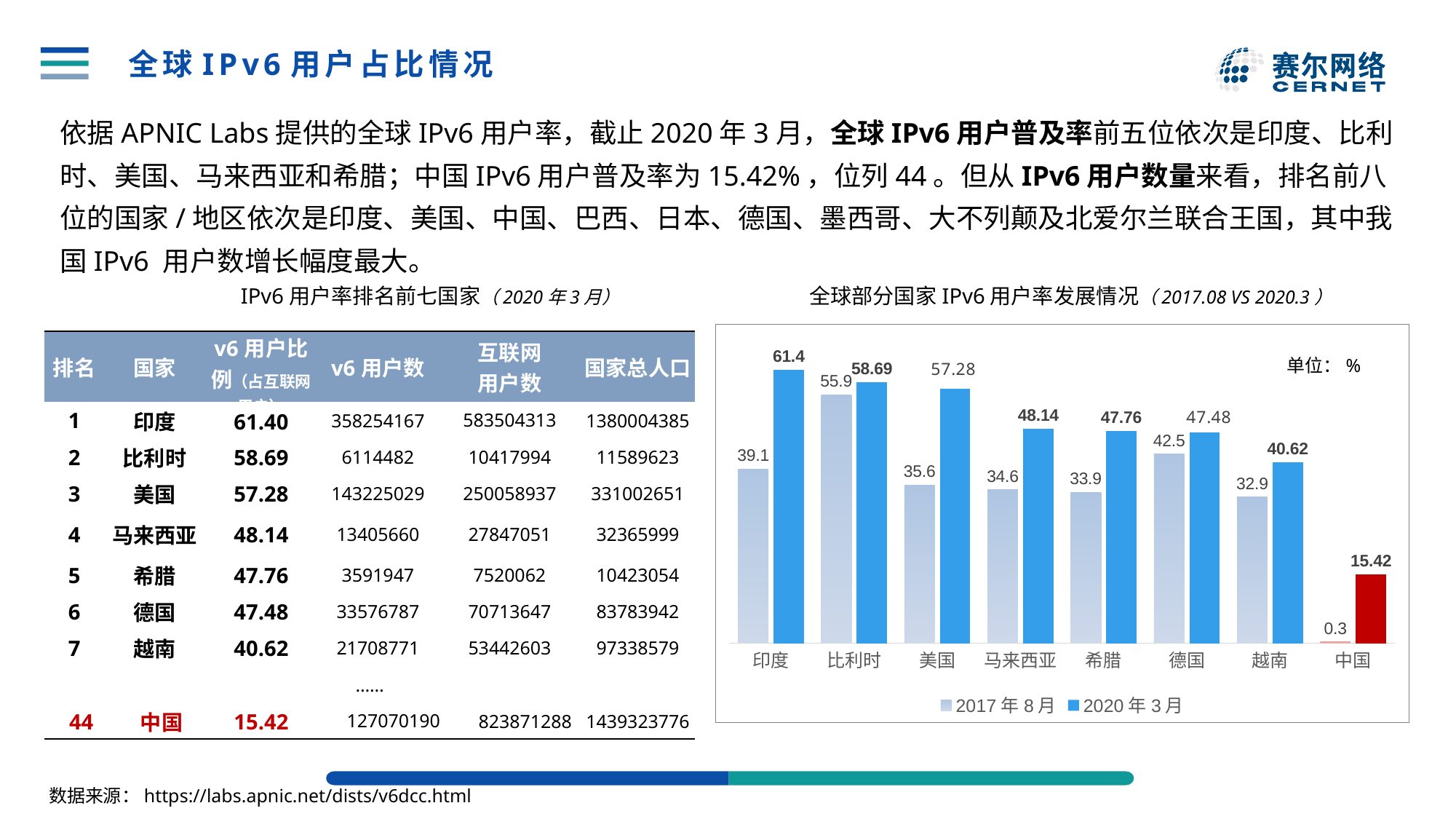
What kind of chart is shown on the right side of the slide? bar chart In the chart on the right, which country has the lowest value for 2017年8月? 中国 In the chart on the right, which is larger: the 2017年8月 value for 德国 or the 2017年8月 value for 印度? 德国 In the chart on the right, how many countries are shown on the x axis? 8 In the chart on the right, what unit is indicated for the values? % In the chart on the right, which country has the highest value for 2020年3月? 印度 In the chart on the right, how many series does the legend list? 2 In the chart on the right, what is the difference between the 2020年3月 and 2017年8月 values for 美国? 21.68 In the chart on the right, what is the value for 比利时 in 2017年8月? 55.9 In the chart on the right, what is the value for 印度 in 2020年3月? 61.4 In the chart on the right, what is the value for 中国 in 2020年3月? 15.42 In the chart on the right, what is the difference between the 2020年3月 values for 印度 and 中国? 45.98